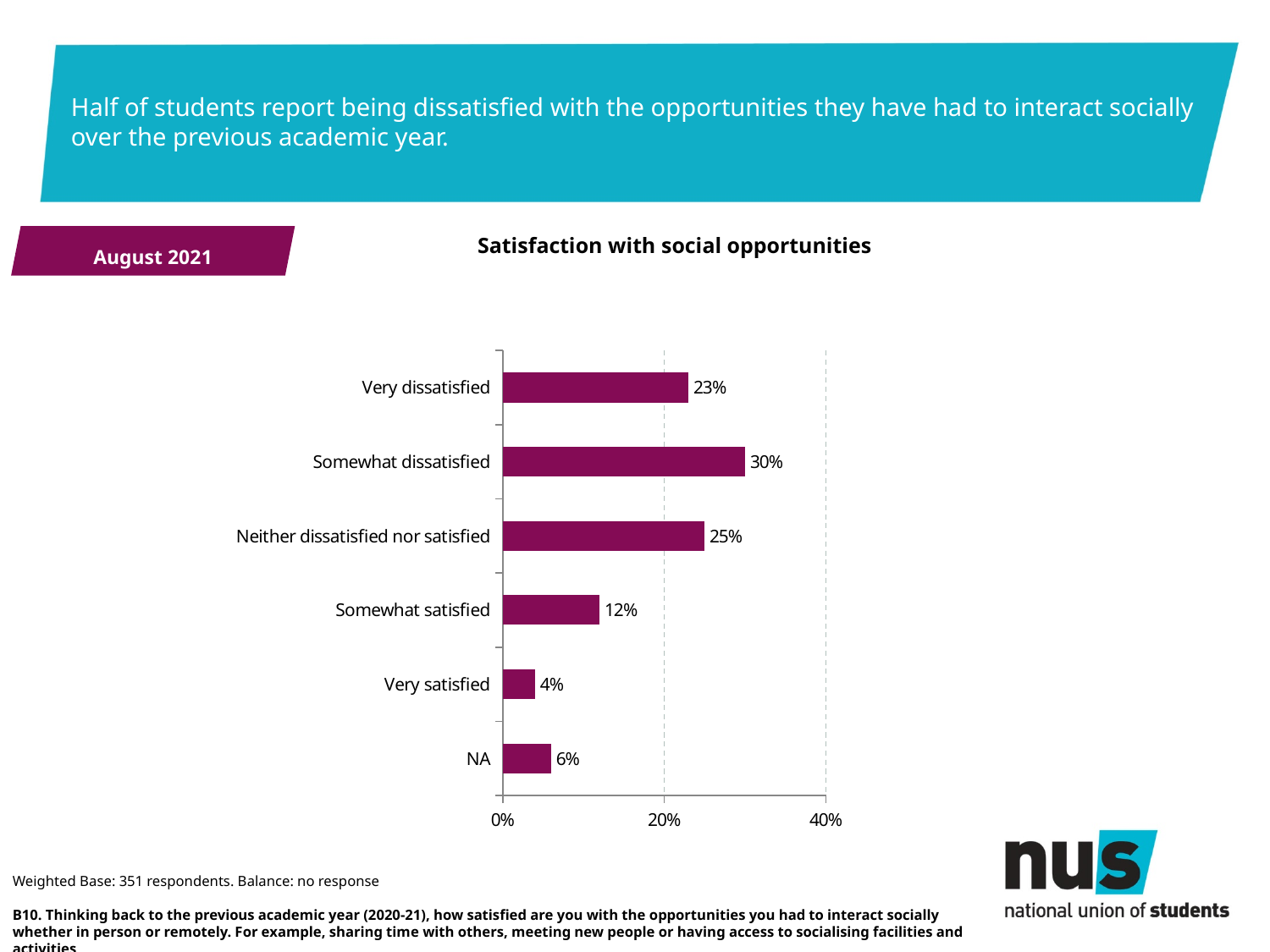
Which category has the lowest value? Very satisfied What is the combined percentage of 'Very dissatisfied' and 'Somewhat dissatisfied'? 53% What percentage of respondents answered 'NA'? 6% Is the value for 'Very dissatisfied' greater or less than 20%? greater What kind of chart is shown on the slide? Bar chart What is the value for 'Very satisfied'? 4% What is the title of the chart? Satisfaction with social opportunities What percentage of students were somewhat dissatisfied with social opportunities? 30% What is the difference between 'Somewhat dissatisfied' and 'Very dissatisfied'? 7% How many categories are shown in the chart? 6 Which is larger: 'Neither dissatisfied nor satisfied' or 'Somewhat satisfied'? Neither dissatisfied nor satisfied Which category has the highest value? Somewhat dissatisfied